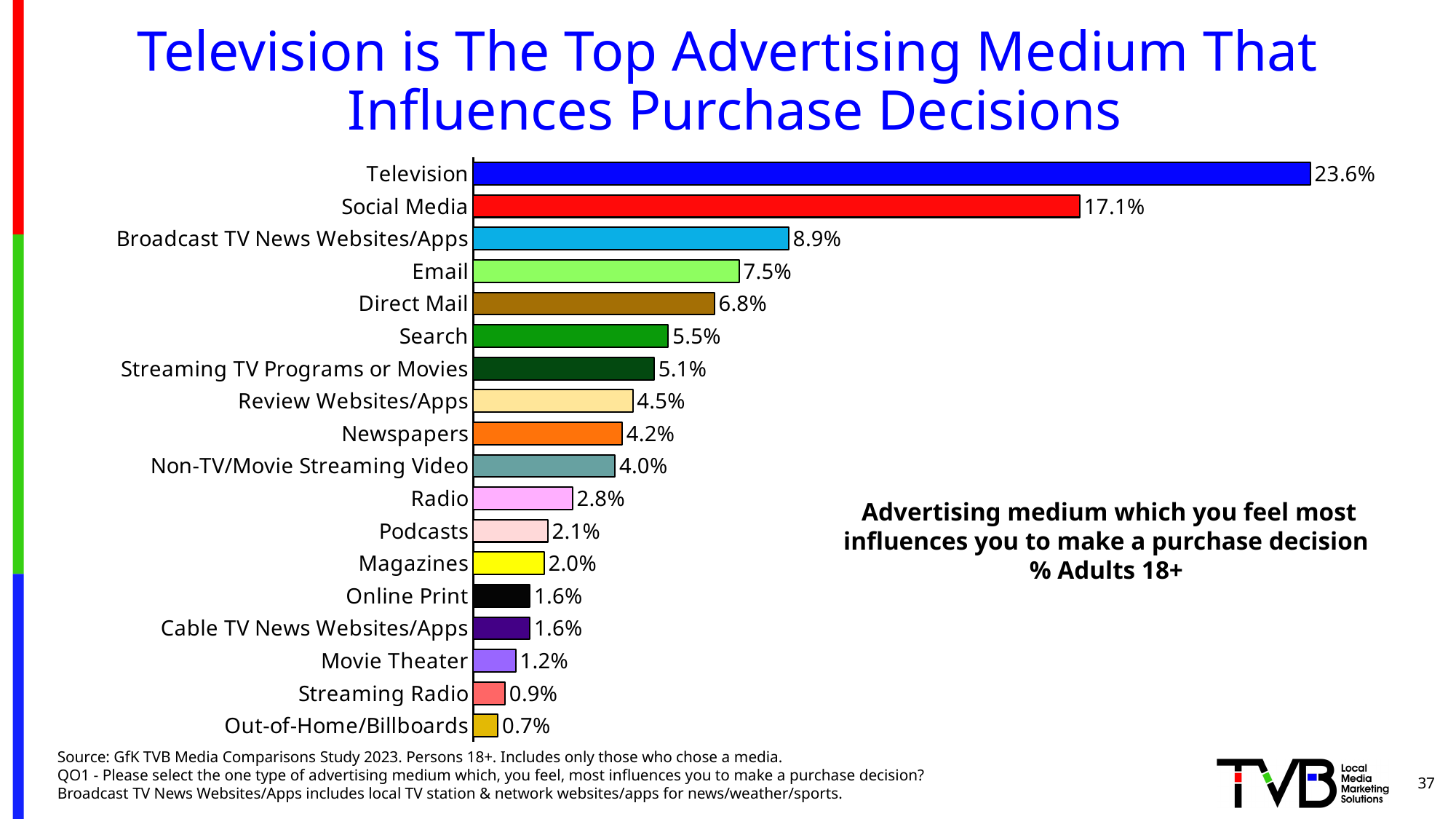
What is the value shown for Social Media? 17.1% Which advertising medium has the highest value on the chart? Television How many advertising media categories are shown on the chart? 18 What percentage of adults 18+ chose Television as the advertising medium that most influences their purchase decision? 23.6% Which has a larger value, Email or Search? Email What is the difference between the values for Television and Social Media? 6.5% What is the difference between the values for Radio and Magazines? 0.8% Which advertising medium has the lowest value on the chart? Out-of-Home/Billboards What is the value shown for Podcasts? 2.1% What colour is the bar for Magazines? Yellow What kind of chart is shown on the slide? Bar chart What is the value shown for Direct Mail? 6.8%